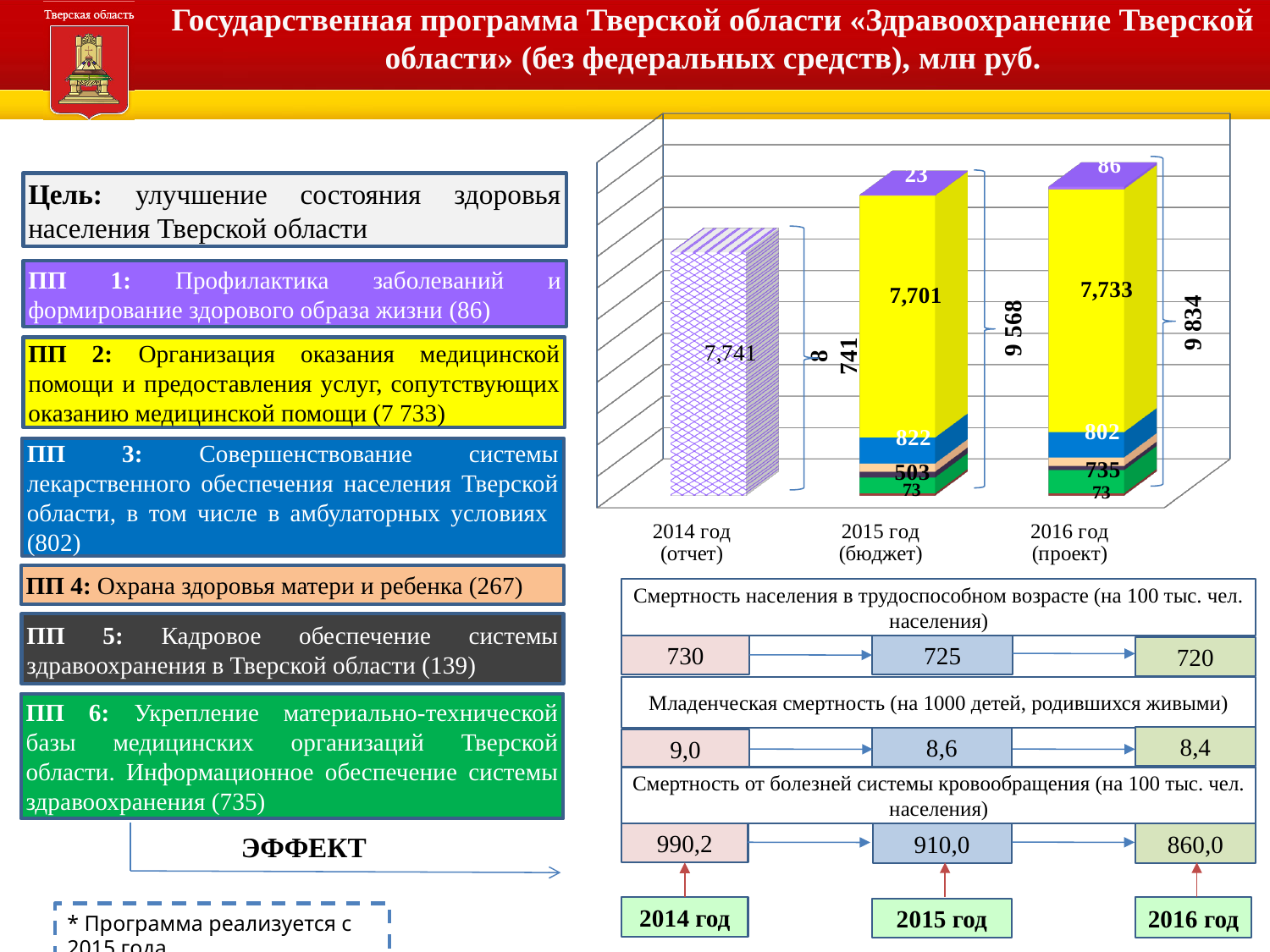
What is the total shown for the 2015 год (бюджет) bar? 9 568 Which bar has the larger total, 2015 год (бюджет) or 2016 год (проект)? 2016 год (проект) How many year categories are shown along the x axis of the bar chart? 3 What is the difference between the totals of the 2016 год and 2015 год bars? 266 What is the value of the blue segment for 2015 год (бюджет)? 822 What kind of chart is shown on the slide? bar chart What is the value labelled on the 2014 год (отчет) bar? 7,741 What is the value of the yellow segment for 2015 год (бюджет)? 7,701 What is the total shown for the 2016 год (проект) bar? 9 834 What is the value of the yellow segment for 2016 год (проект)? 7,733 What is the value of the purple top segment for 2016 год (проект)? 86 By how much does the yellow segment for 2016 год exceed the yellow segment for 2015 год? 32